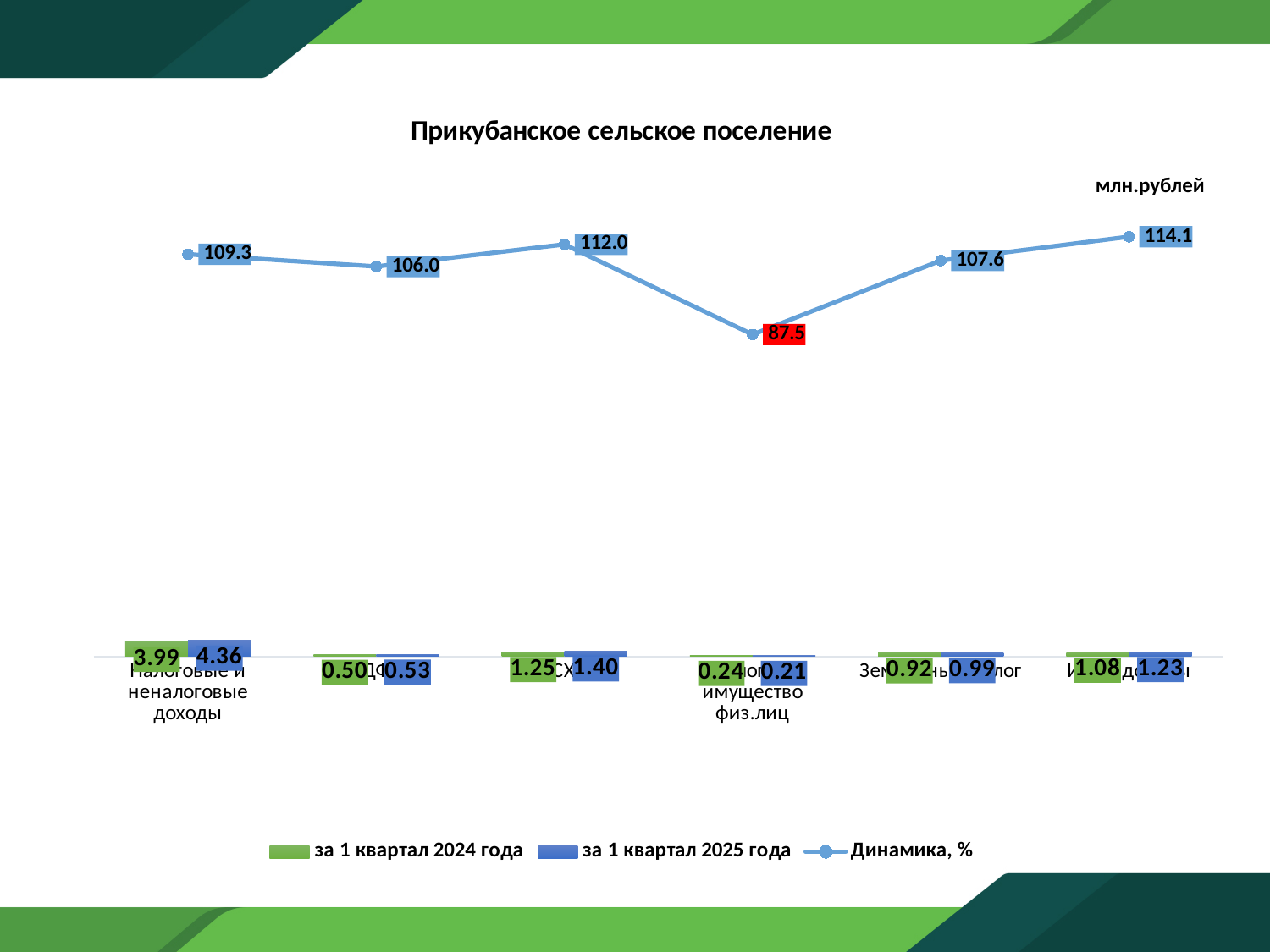
What is the title of the chart? Прикубанское сельское поселение What is the value for имущество физ.лиц за 1 квартал 2025 года? 0.21 What is the value for Налоговые и неналоговые доходы за 1 квартал 2025 года? 4.36 What is the value for Налоговые и неналоговые доходы за 1 квартал 2024 года? 3.99 What is the difference between the 2025 and 2024 values for Налоговые и неналоговые доходы? 0.37 What is the lowest value on the Динамика, % line? 87.5 What is the Динамика, % value for Налоговые и неналоговые доходы? 109.3 How many categories are shown on the x axis? 6 How many series does the legend list? 3 What is the highest value on the Динамика, % line? 114.1 For имущество физ.лиц, which is larger: the value за 1 квартал 2024 года or за 1 квартал 2025 года? за 1 квартал 2024 года What is the Динамика, % value for имущество физ.лиц? 87.5